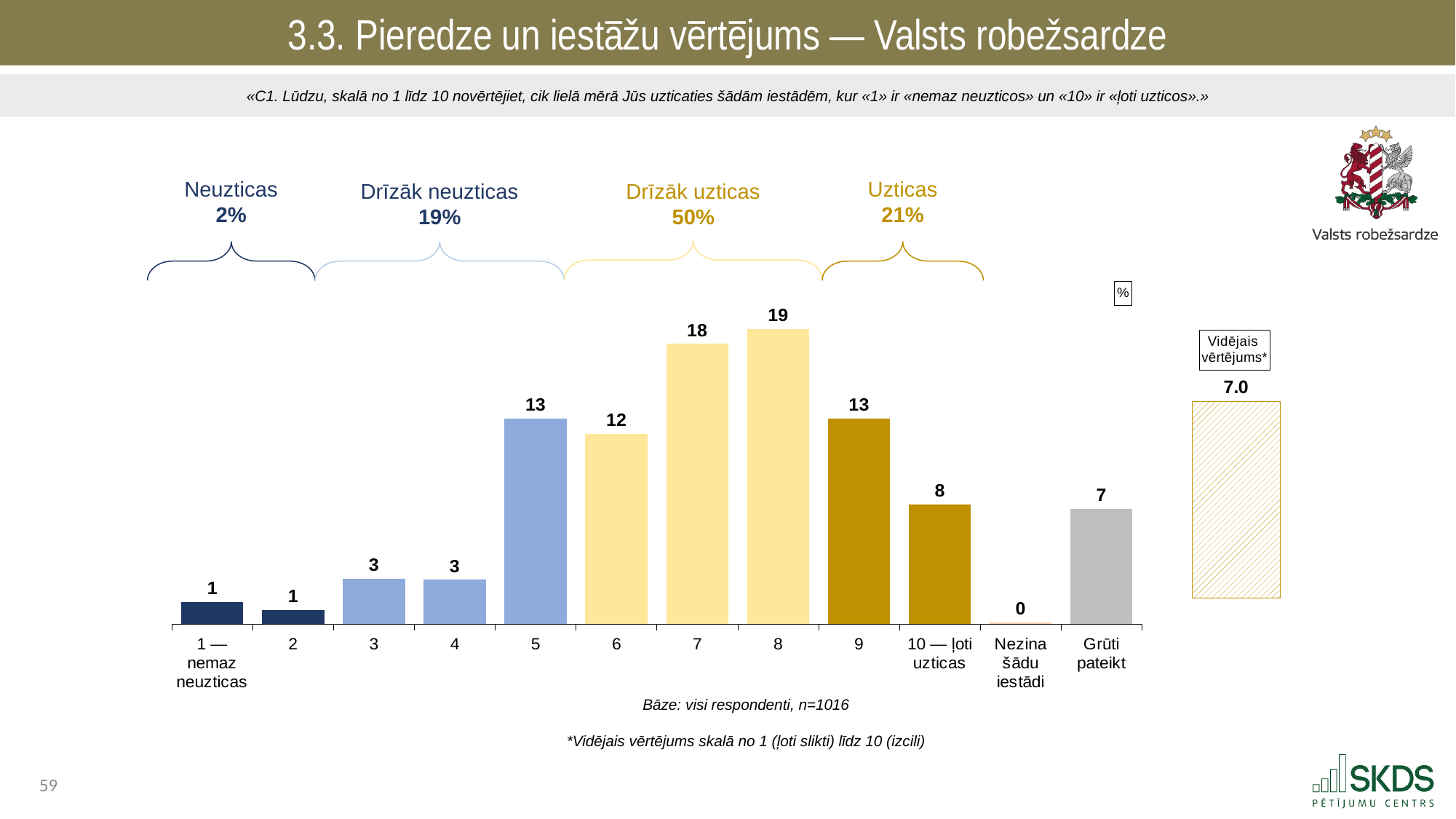
Which rating category has the highest bar? 8 What percentage is shown for the 'Drīzāk uzticas' group? 50% What type of chart is shown on the slide? bar chart What value is shown for the 'Grūti pateikt' category? 7 What is the value for 'Nezina šādu iestādi'? 0 What is the difference between the values for rating 7 and rating 6? 6 What is the average rating ('Vidējais vērtējums') shown on the slide? 7.0 What is the value shown for the rating 5 bar? 13 What is the sample size stated in the base note below the chart? n=1016 What percentage of respondents gave a rating of 8? 19 How many bars are plotted in the chart? 12 Which is larger, the value for rating 9 or the value for '10 — ļoti uzticas'? 9